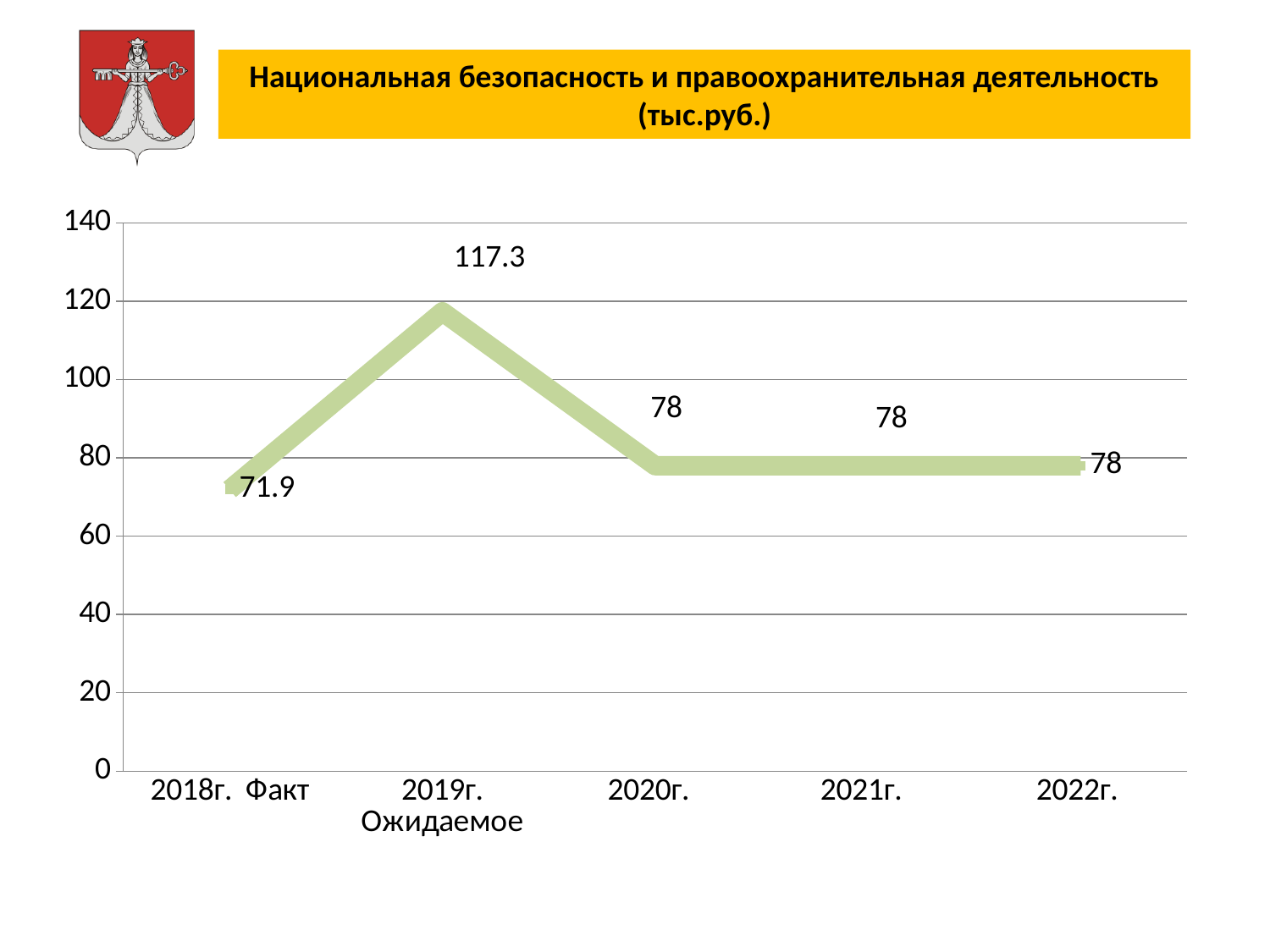
What is the value for 2021г.? 78 Is the value for 2019г. Ожидаемое greater or less than 100? greater What is the value for 2019г. Ожидаемое? 117.3 What is the difference between the values for 2020г. and 2018г. Факт? 6.1 Which is larger, the value for 2018г. Факт or the value for 2022г.? 2022г. What is the difference between the values for 2019г. Ожидаемое and 2020г.? 39.3 What is the value for 2018г. Факт? 71.9 Which category has the lowest value? 2018г. Факт How many categories are shown on the x axis? 5 Which category has the highest value? 2019г. Ожидаемое What kind of chart is shown on the slide? line chart What is the title of the chart? Национальная безопасность и правоохранительная деятельность (тыс.руб.)